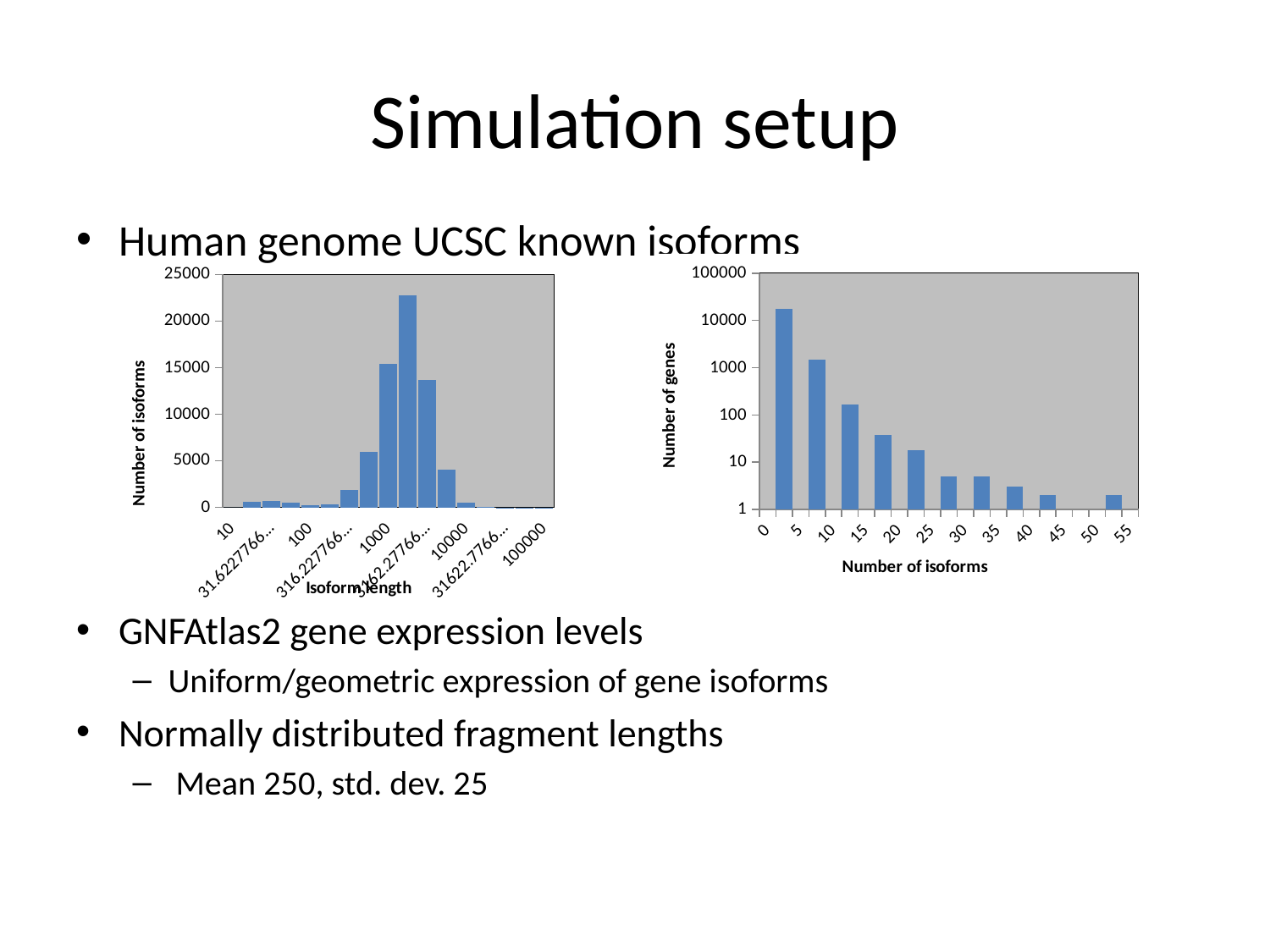
On the right chart, how many bars are plotted? 10 What kind of chart is the left chart (Isoform length)? bar chart On the right chart, what is the y-axis title? Number of genes What kind of chart is the right chart (Number of isoforms vs Number of genes)? bar chart On the left chart, what is the y-axis title? Number of isoforms On the right chart, is the value of the bar between 15 and 20 isoforms greater or less than 100? less On the right chart, do the bar values generally rise or fall as the number of isoforms increases? fall On the left chart, is the value of the tallest bar greater or less than 20000? greater On the right chart, is the value of the tallest bar greater or less than 10000? greater On the right chart, which bar is the tallest: the first bar (0 to 5 isoforms) or the last bar (50 to 55 isoforms)? the first bar (0 to 5 isoforms)